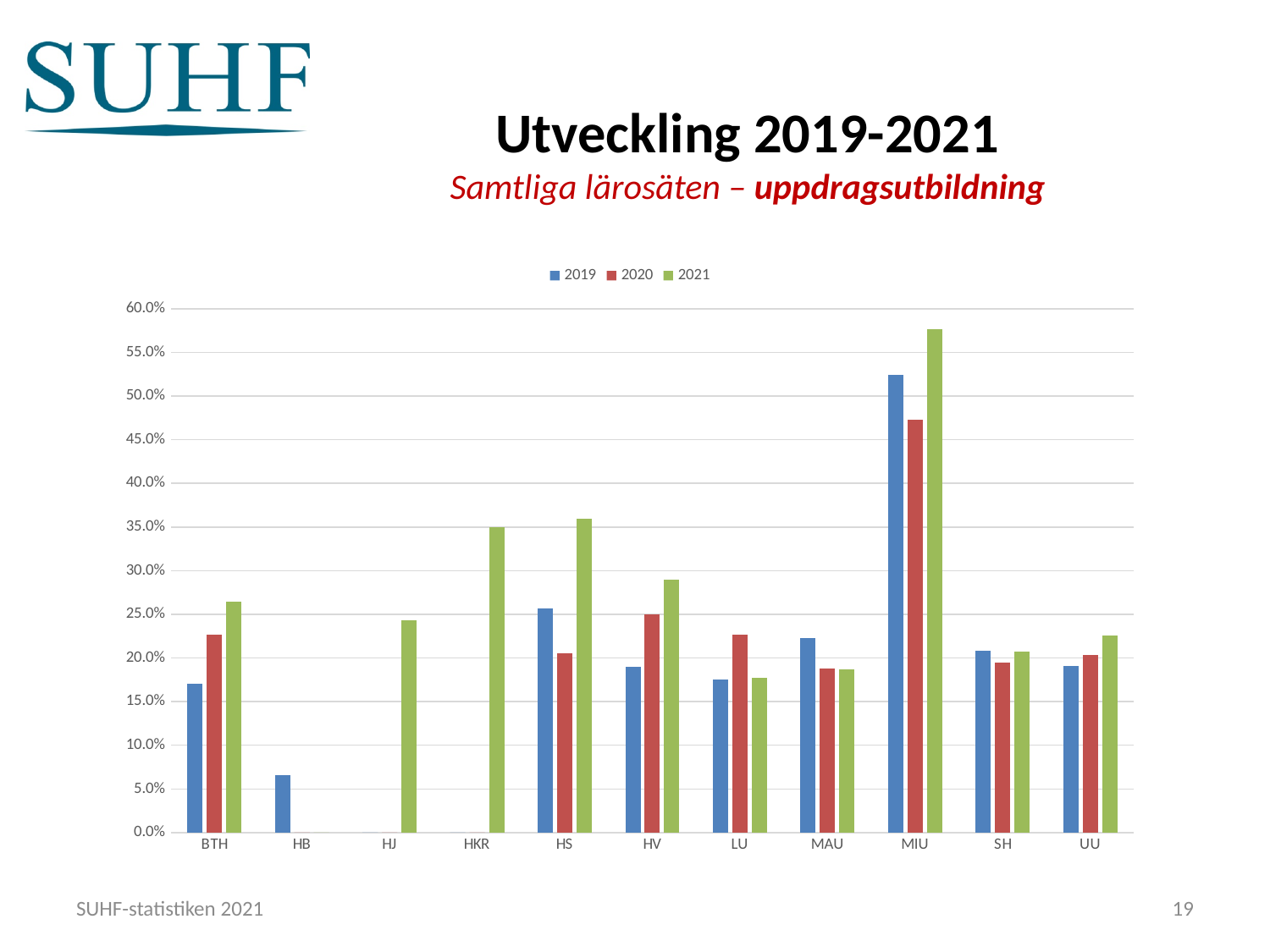
Is the 2021 value for MIU greater or less than 55.0%? greater Does the value for BTH rise or fall from 2019 to 2021? rise Is the 2019 value for BTH greater or less than 15.0%? greater Is the 2020 value for MIU greater or less than 50.0%? less Which category has the tallest 2021 bar? MIU How many series does the legend list? 3 Which category has the shortest 2019 bar? HB How many categories are shown on the x axis? 11 For LU, which is larger: the 2019 value or the 2020 value? 2020 For HS, which is larger: the 2019 value or the 2020 value? 2019 What kind of chart is shown on the slide? bar chart